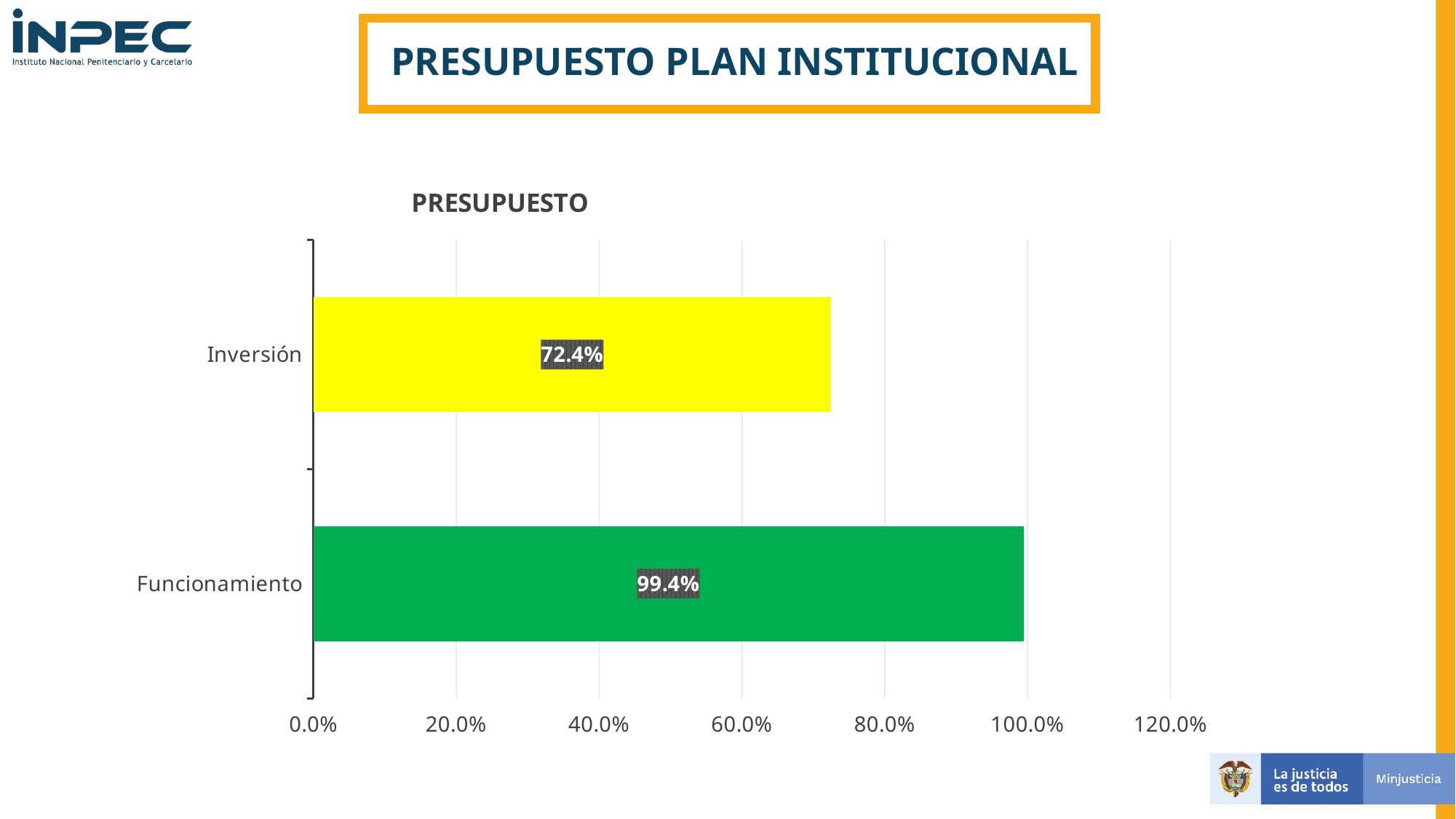
Is the value for Inversión greater or less than 80.0%? less Which category has the highest value? Funcionamiento What colour is the bar for Funcionamiento? Green Which category has the lowest value? Inversión What kind of chart is shown on the slide? Bar chart What is the value for Funcionamiento? 99.4% What is the difference between the values for Funcionamiento and Inversión? 27.0% How many categories are shown in the chart? 2 What is the value for Inversión? 72.4% Which is larger, the value for Inversión or the value for Funcionamiento? Funcionamiento Is the value for Funcionamiento greater or less than 80.0%? greater What is the title of the chart? PRESUPUESTO